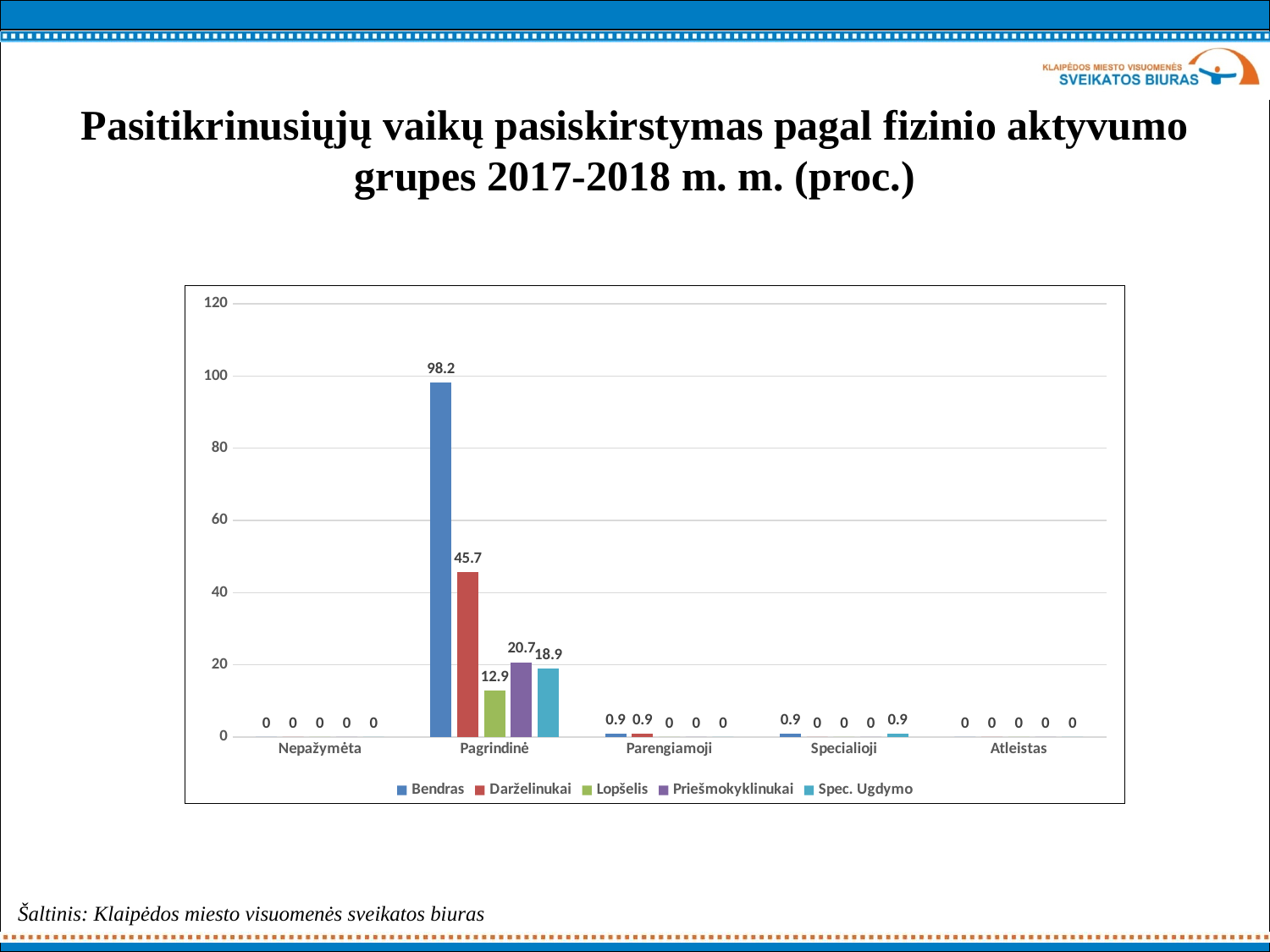
How many series does the legend list? 5 What is the value for Bendras in the Pagrindinė category? 98.2 Which series has the highest value in the Pagrindinė category? Bendras Which series has the lowest value in the Pagrindinė category? Lopšelis How many categories are shown on the x axis? 5 Is the value for Darželinukai in the Pagrindinė category greater or less than 40? greater What is the value for Lopšelis in the Pagrindinė category? 12.9 What is the value for Darželinukai in the Pagrindinė category? 45.7 What is the value for Spec. Ugdymo in the Specialioji category? 0.9 In the Pagrindinė category, which is larger: Priešmokyklinukai or Spec. Ugdymo? Priešmokyklinukai What kind of chart is shown on the slide? Bar chart What is the difference between the Bendras and Darželinukai values in the Pagrindinė category? 52.5